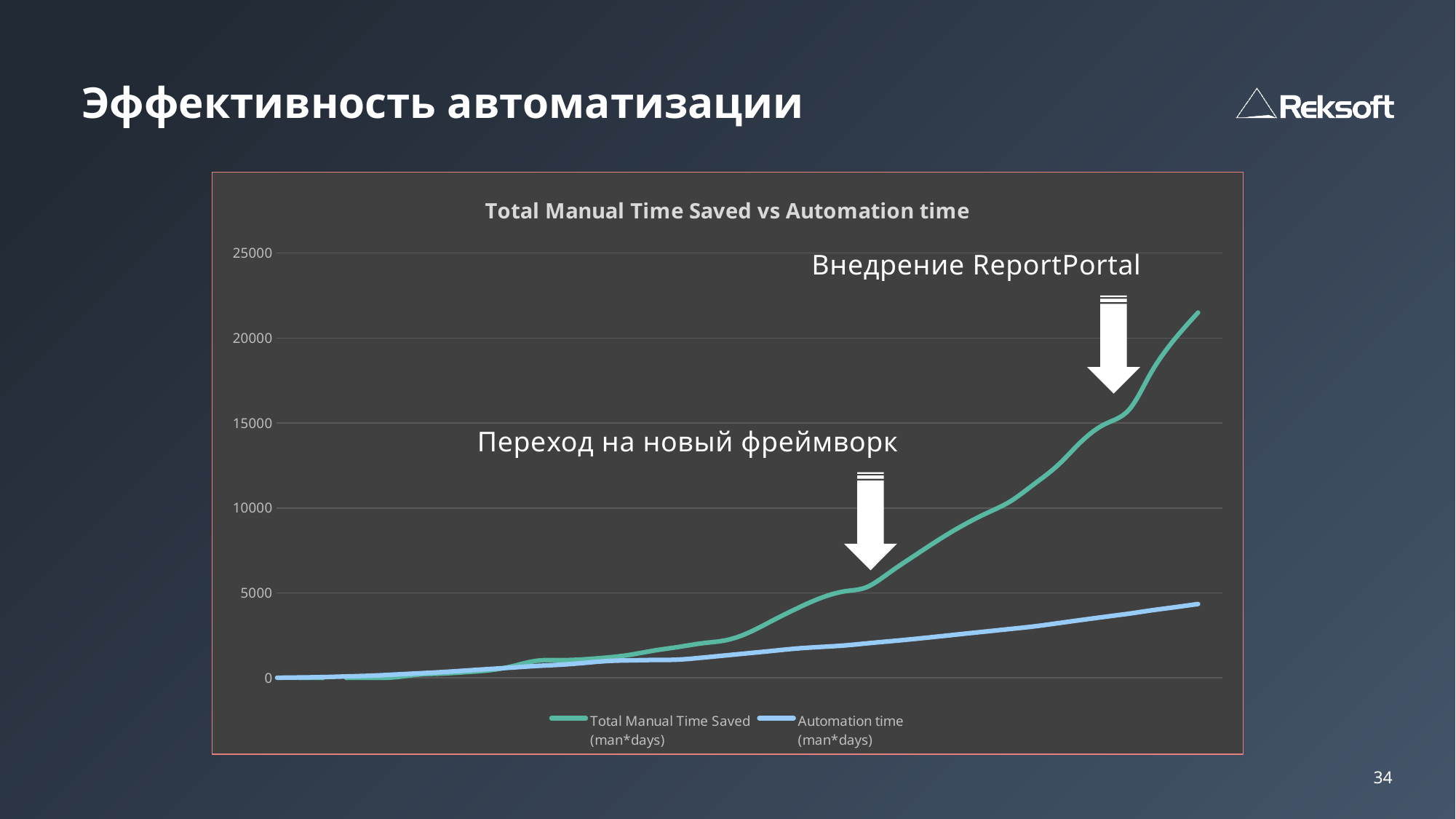
Is the final value of the Automation time line greater or less than 5000? less Is the value of the Automation time line at its highest point greater or less than 10000? less How many series does the chart's legend list? 2 Is the highest value of the Total Manual Time Saved line greater or less than 25000? less What kind of chart is shown on the slide? line chart Which series reaches the highest value on the chart? Total Manual Time Saved Which series is plotted with the green line? Total Manual Time Saved (man*days) At the right end of the chart, which series has the higher value: Total Manual Time Saved or Automation time? Total Manual Time Saved Does the Automation time line rise or fall along the x axis? rise What is the title of the chart? Total Manual Time Saved vs Automation time Does the Total Manual Time Saved line rise or fall along the x axis? rise